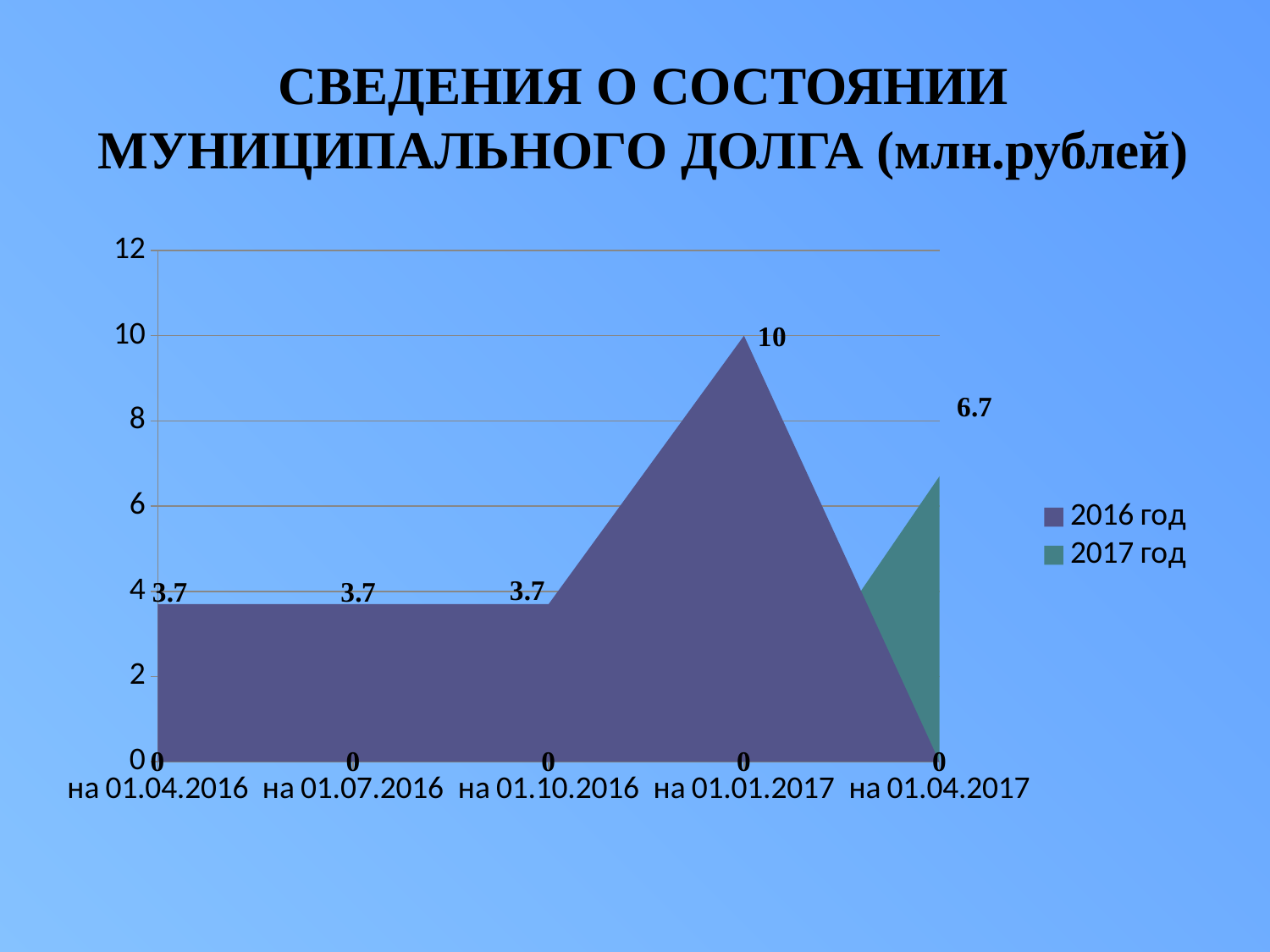
What is the value for the 2016 год series at на 01.04.2016? 3.7 What unit is given in the chart title? млн.рублей What is the difference between the 2016 год value at на 01.01.2017 and its value at на 01.10.2016? 6.3 At which date does the 2016 год series reach its highest value? на 01.01.2017 What is the difference between the 2016 год value at на 01.01.2017 and the 2017 год value at на 01.04.2017? 3.3 What is the value for the 2017 год series at на 01.01.2017? 0 What kind of chart is shown on the slide? area chart Which is larger: the 2016 год value at на 01.01.2017 or the 2017 год value at на 01.04.2017? 2016 год at на 01.01.2017 What is the value for the 2016 год series at на 01.01.2017? 10 What is the value for the 2017 год series at на 01.04.2017? 6.7 How many series does the legend list? 2 How many dates are shown along the x axis? 5